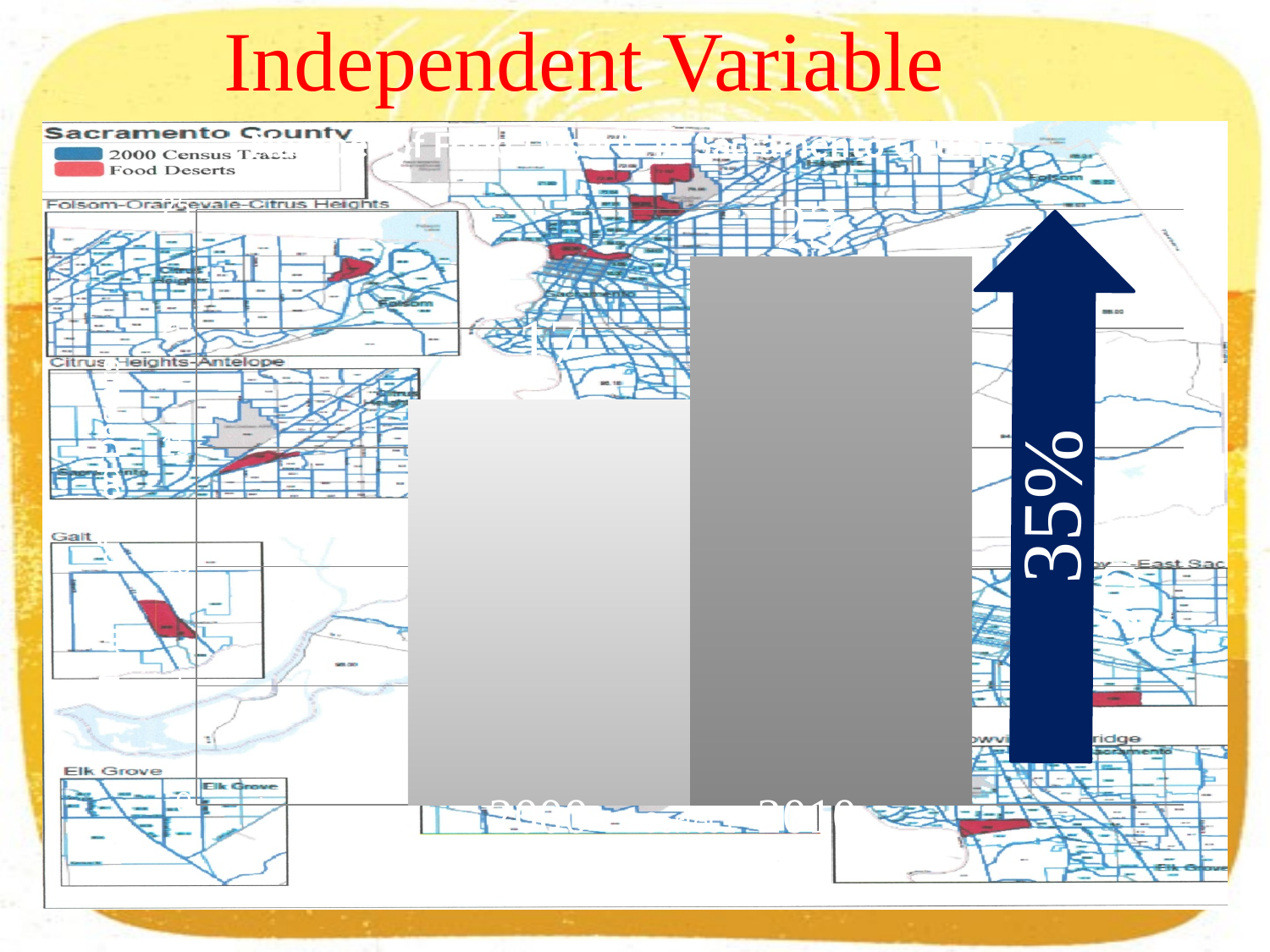
Which year has the taller bar in the chart, 2000 or 2010? 2010 Which year has the shorter bar in the chart? 2000 What kind of chart is shown on the slide? bar chart Is the value for 2010 larger or smaller than the value for 2000? larger Which two years are labelled on the x axis of the bar chart? 2000 and 2010 What is the difference between the 2010 value and the 2000 value in the bar chart? 6 What is the value shown for 2000 in the bar chart? 17 Do the values rise or fall from 2000 to 2010? rise What is the value shown for 2010 in the bar chart? 23 What percentage is written on the large upward arrow next to the chart? 35% How many bars are plotted in the chart? 2